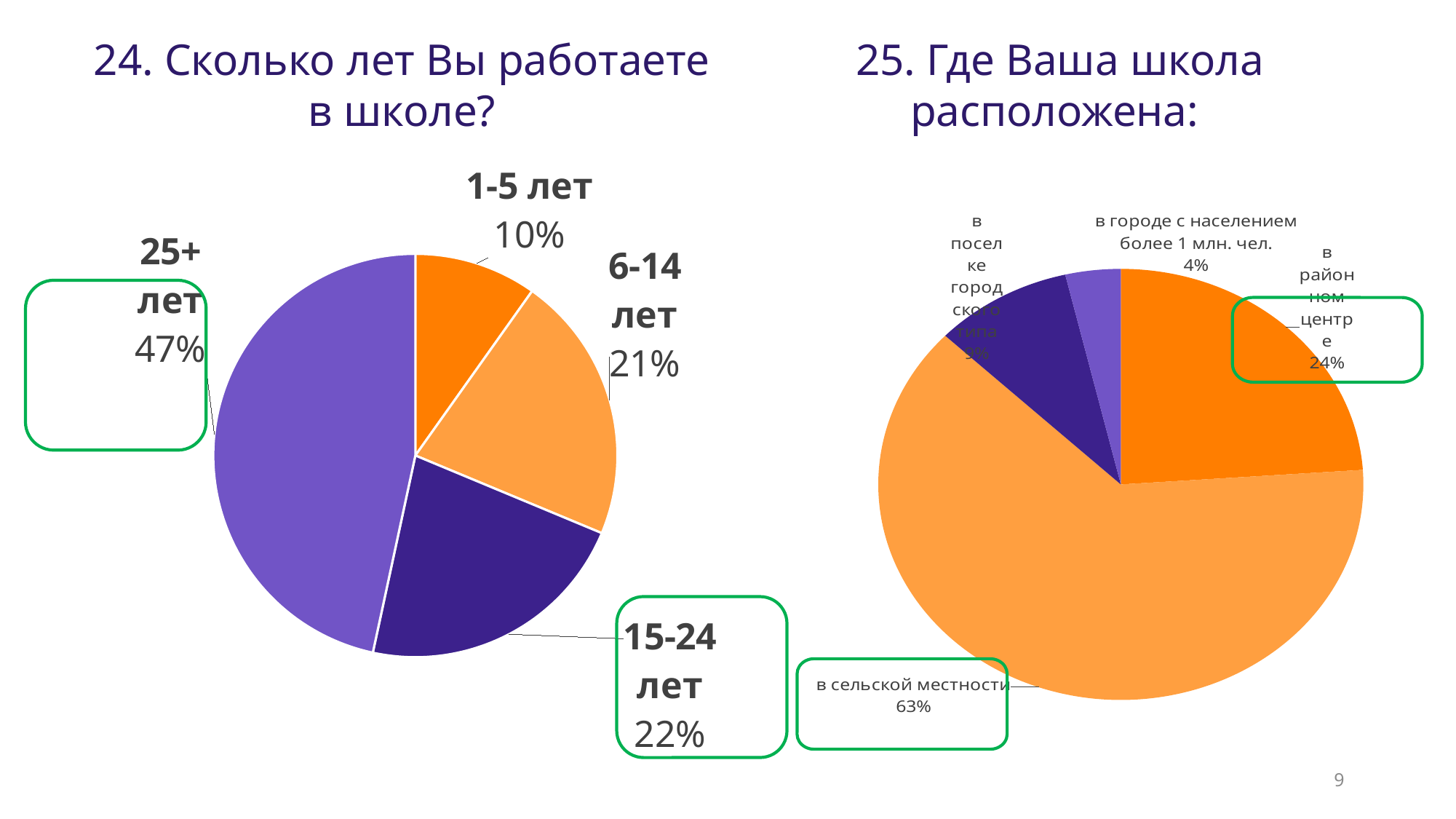
On the chart titled "25. Где Ваша школа расположена:", which category has the largest share? в сельской местности On the chart titled "24. Сколько лет Вы работаете в школе?", which category has the largest share? 25+ лет On the chart titled "24. Сколько лет Вы работаете в школе?", how many categories are shown? 4 On the chart titled "25. Где Ваша школа расположена:", what percentage is shown for в городе с населением более 1 млн. чел.? 4% What type of chart is used for "24. Сколько лет Вы работаете в школе?"? Pie chart On the chart titled "24. Сколько лет Вы работаете в школе?", what share of respondents have worked 25+ лет? 47% On the chart titled "25. Где Ваша школа расположена:", what share of schools are located в сельской местности? 63% On the chart titled "24. Сколько лет Вы работаете в школе?", what percentage is shown for 1-5 лет? 10% On the chart titled "25. Где Ваша школа расположена:", what percentage is shown for в районном центре? 24% On the chart titled "24. Сколько лет Вы работаете в школе?", what is the difference in percentage points between 15-24 лет and 6-14 лет? 1 percentage point On the chart titled "25. Где Ваша школа расположена:", which is larger: в районном центре or в городе с населением более 1 млн. чел.? в районном центре On the chart titled "24. Сколько лет Вы работаете в школе?", which category has the smallest share? 1-5 лет